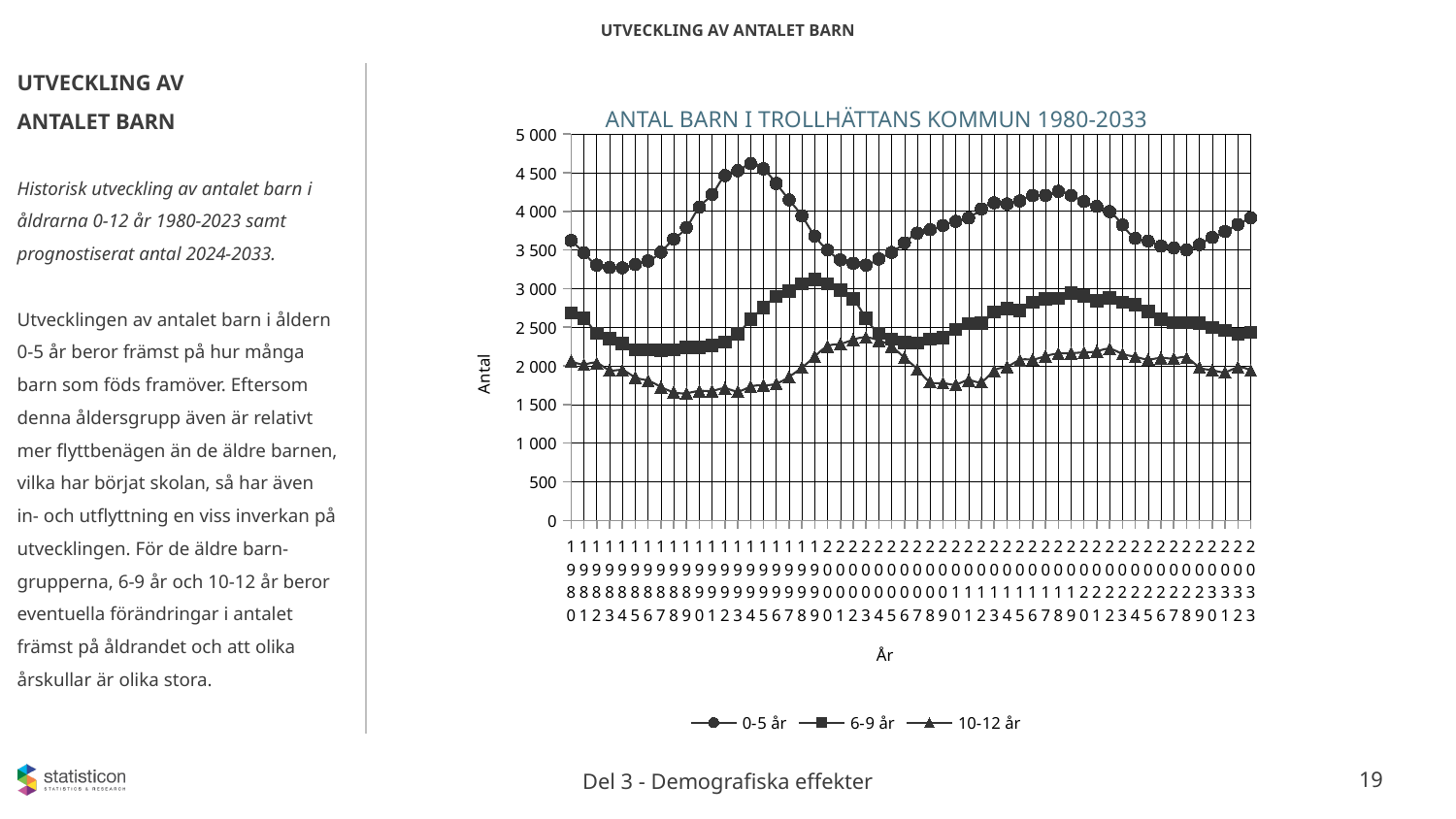
Is the value for 6-9 år in 1980 greater or less than 2 500? greater What kind of chart is shown on the slide? Line chart Is the value for 10-12 år in 1993 greater or less than 2 000? less Which series has the highest value in 1980? 0-5 år Does the value for 0-5 år rise or fall from 1985 to 1994? rise Which series has the lowest value in 2033? 10-12 år What is the label of the vertical axis of the chart? Antal In 2033, which is larger: the value for 0-5 år or the value for 6-9 år? 0-5 år What is the title of the chart? ANTAL BARN I TROLLHÄTTANS KOMMUN 1980-2033 How many years are plotted along the x axis of the chart? 54 How many series does the legend of the chart list? 3 Is the value for 0-5 år in 1980 greater or less than 3 000? greater